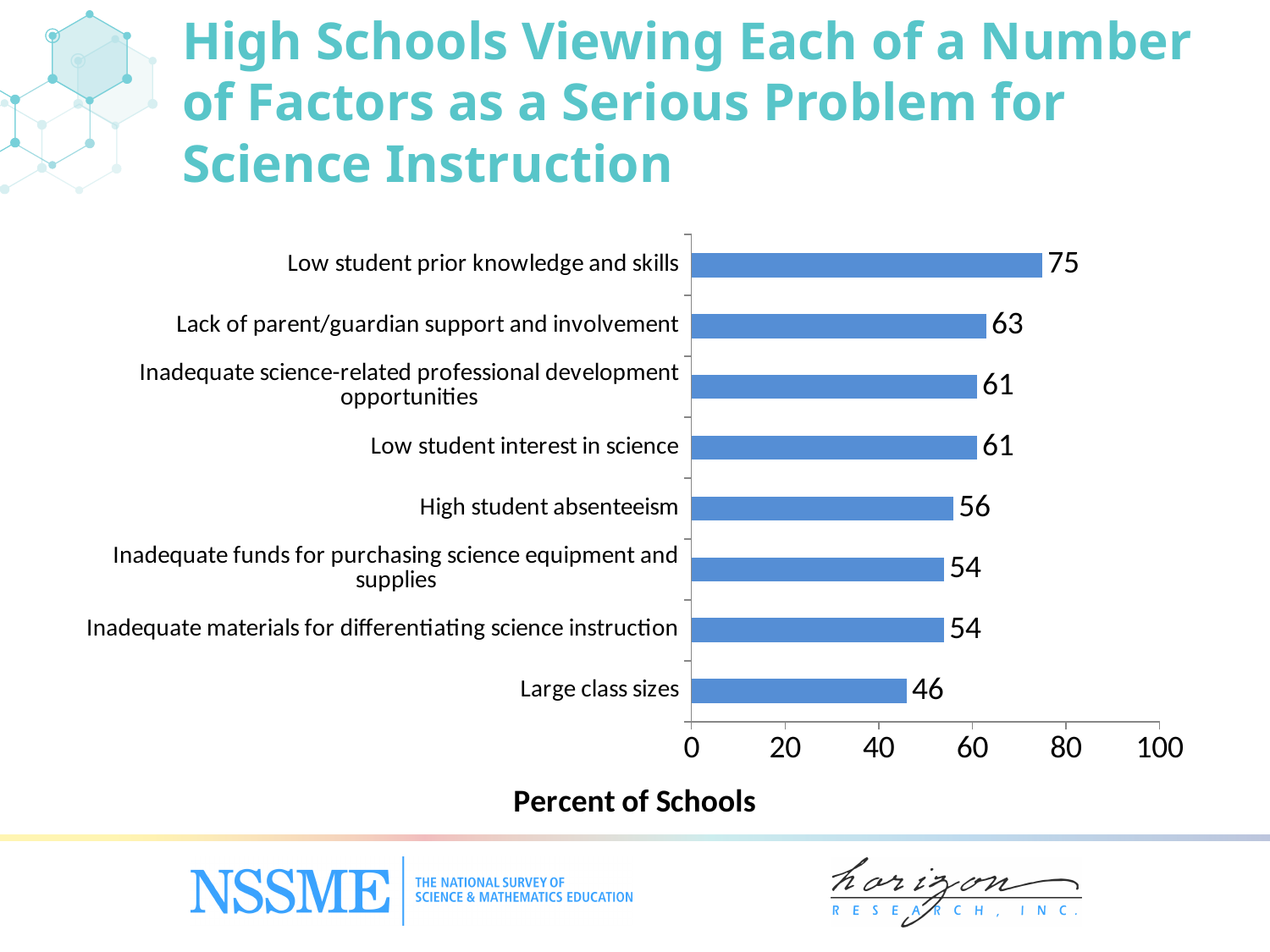
Which is larger: the value for high student absenteeism or the value for large class sizes? High student absenteeism What is the value for high student absenteeism? 56 Is the value for low student interest in science greater or less than 40? greater Which factor has the lowest percent of schools viewing it as a serious problem? Large class sizes What percent of schools view low student prior knowledge and skills as a serious problem? 75 What is the value for large class sizes? 46 How many factors are shown in the chart? 8 What kind of chart is shown on the slide? Bar chart What is the value for lack of parent/guardian support and involvement? 63 Which factor has the highest percent of schools viewing it as a serious problem? Low student prior knowledge and skills What is the difference between the values for low student prior knowledge and skills and large class sizes? 29 What is the label of the horizontal axis? Percent of Schools